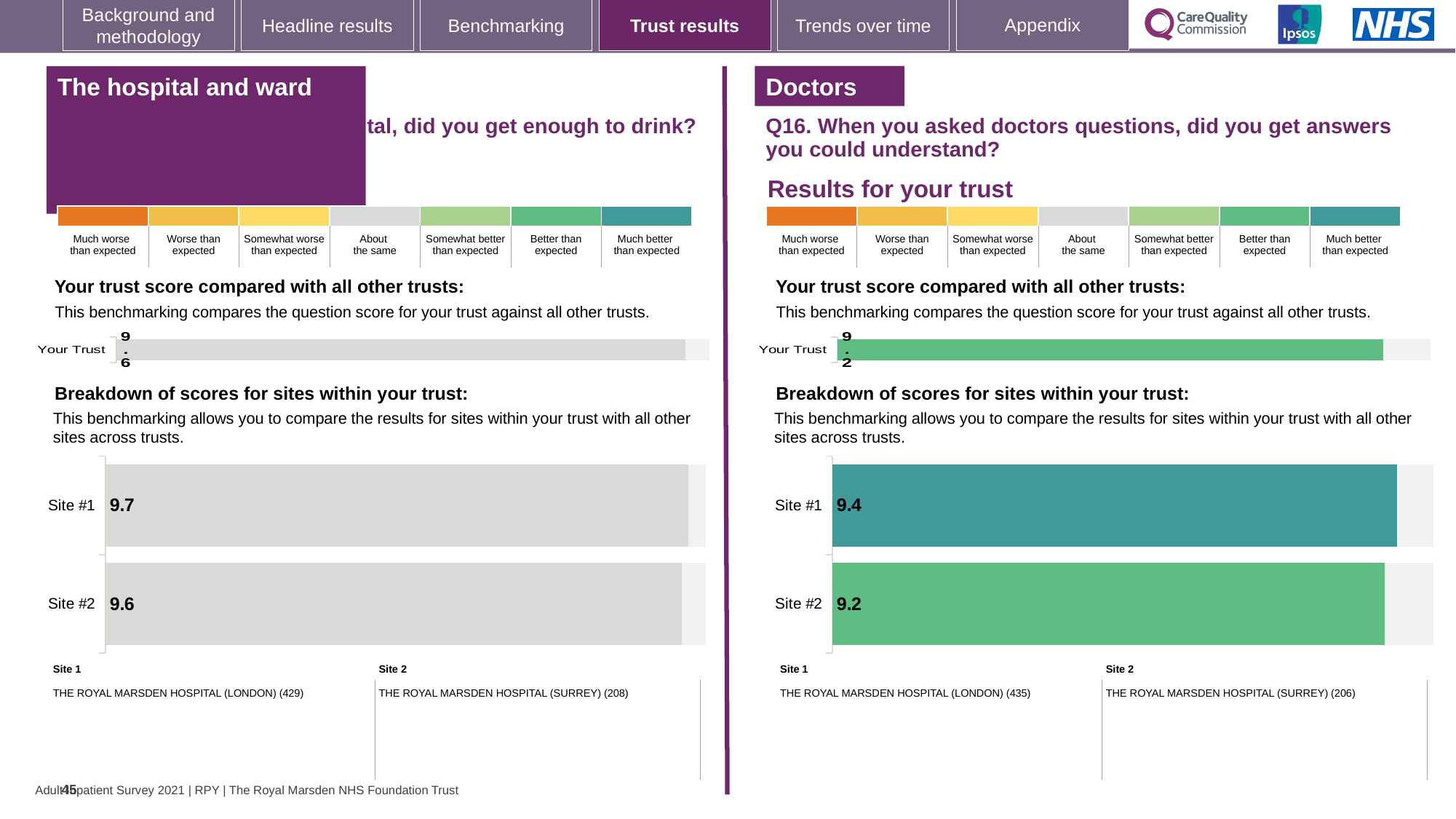
On the left-hand 'The hospital and ward' section, what is the score shown for Site #2 in the breakdown of scores for sites chart? 9.6 How many sites are shown in the breakdown of scores for sites chart on the right-hand 'Doctors' section? 2 On the right-hand 'Doctors' section (Q16), which benchmark category does the colour of the Site #1 bar correspond to in the legend? Much better than expected On the right-hand 'Doctors' section (Q16), what is the difference between the Site #1 and Site #2 scores in the breakdown chart? 0.2 On the left-hand 'The hospital and ward' section, what is the 'Your Trust' score in the trust score chart? 9.6 What type of chart is used for the breakdown of scores for sites on the left-hand 'The hospital and ward' section? Bar chart On the left-hand 'The hospital and ward' section, what is the score shown for Site #1 in the breakdown of scores for sites chart? 9.7 On the right-hand 'Doctors' section (Q16), what is the score shown for Site #1 in the breakdown of scores for sites chart? 9.4 On the right-hand 'Doctors' section (Q16), what is the score shown for Site #2 in the breakdown of scores for sites chart? 9.2 On the right-hand 'Doctors' section (Q16), what is the 'Your Trust' score in the trust score chart? 9.2 On the right-hand 'Doctors' section (Q16), which site has the higher score in the breakdown of scores for sites chart? Site #1 On the left-hand 'The hospital and ward' section, what is the difference between the Site #1 and Site #2 scores in the breakdown chart? 0.1